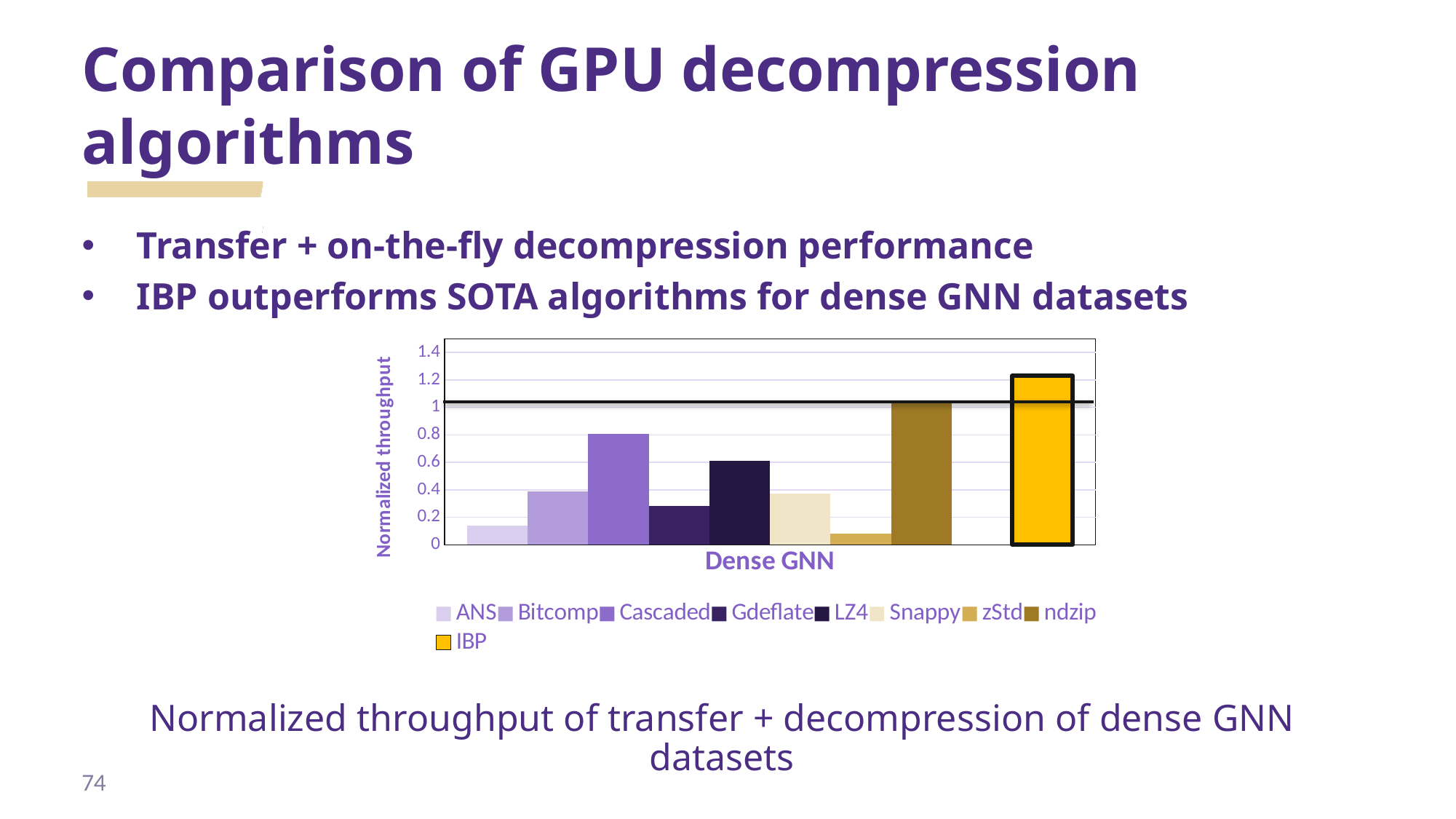
Is the value for Cascaded greater or less than 0.6? greater Which has a larger normalized throughput, ndzip or Gdeflate? ndzip Is the value for LZ4 greater or less than 0.4? greater Which has a larger normalized throughput, Cascaded or LZ4? Cascaded What is the label on the y axis of the chart? Normalized throughput What kind of chart is shown on the slide? bar chart How many series does the legend list? 9 Which algorithm has the lowest normalized throughput for Dense GNN? zStd Is the value for ANS greater or less than 0.2? less Which algorithm has the highest normalized throughput for Dense GNN? IBP